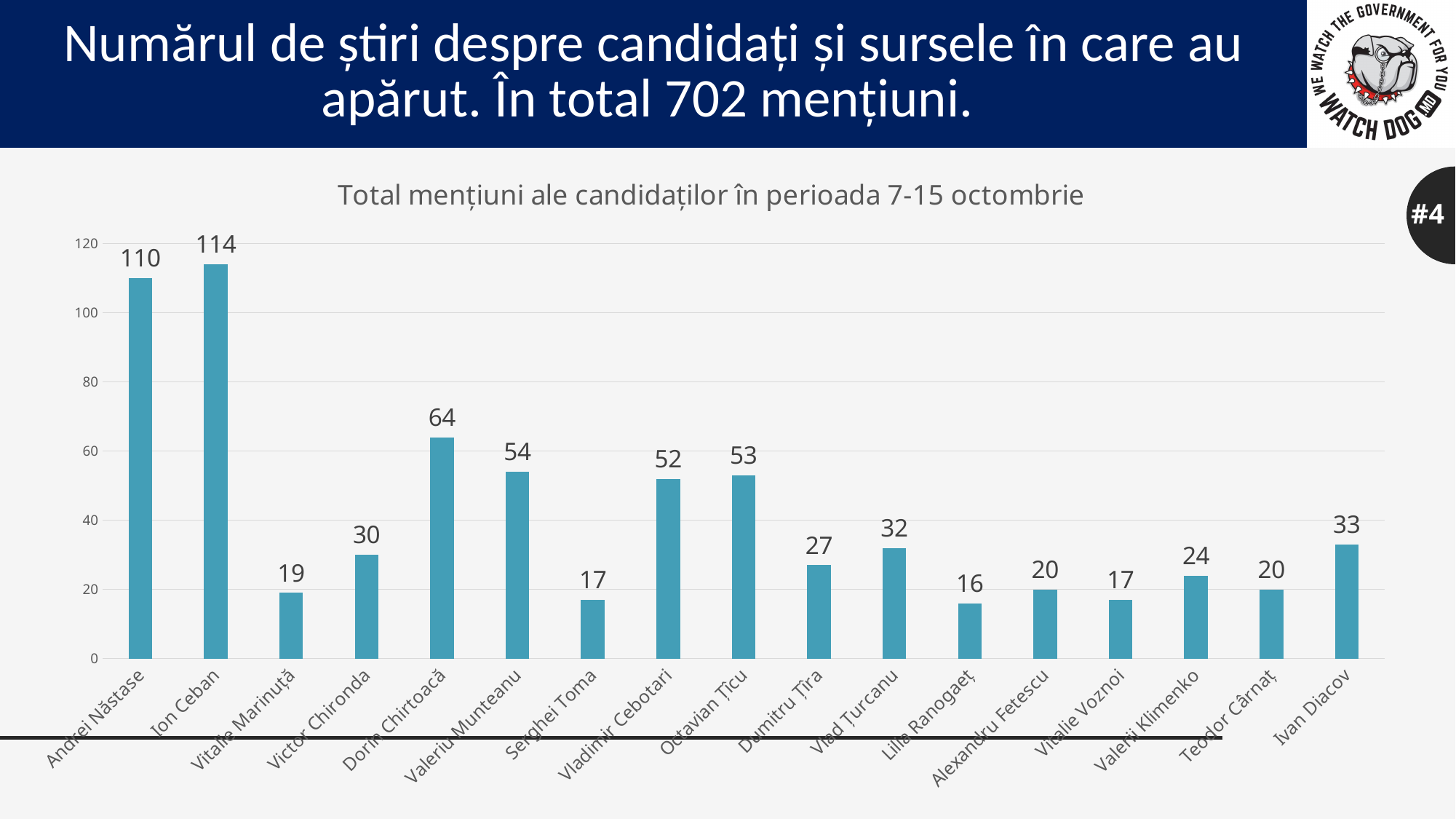
How many mentions does Dorin Chirtoacă have? 64 Which candidate has the highest number of mentions? Ion Ceban Which candidate has the lowest number of mentions? Lilia Ranogaeț How many mentions does Ivan Diacov have? 33 Who has more mentions, Valeriu Munteanu or Vladimir Cebotari? Valeriu Munteanu How many candidates are shown on the x axis of the chart? 17 How many mentions does Andrei Năstase have? 110 What type of chart is shown on the slide? bar chart What is the difference in mentions between Dorin Chirtoacă and Victor Chironda? 34 What is the difference in mentions between Ion Ceban and Andrei Năstase? 4 What is the title of the chart? Total mențiuni ale candidaților în perioada 7-15 octombrie Is the value for Vlad Țurcanu greater or less than 40? less